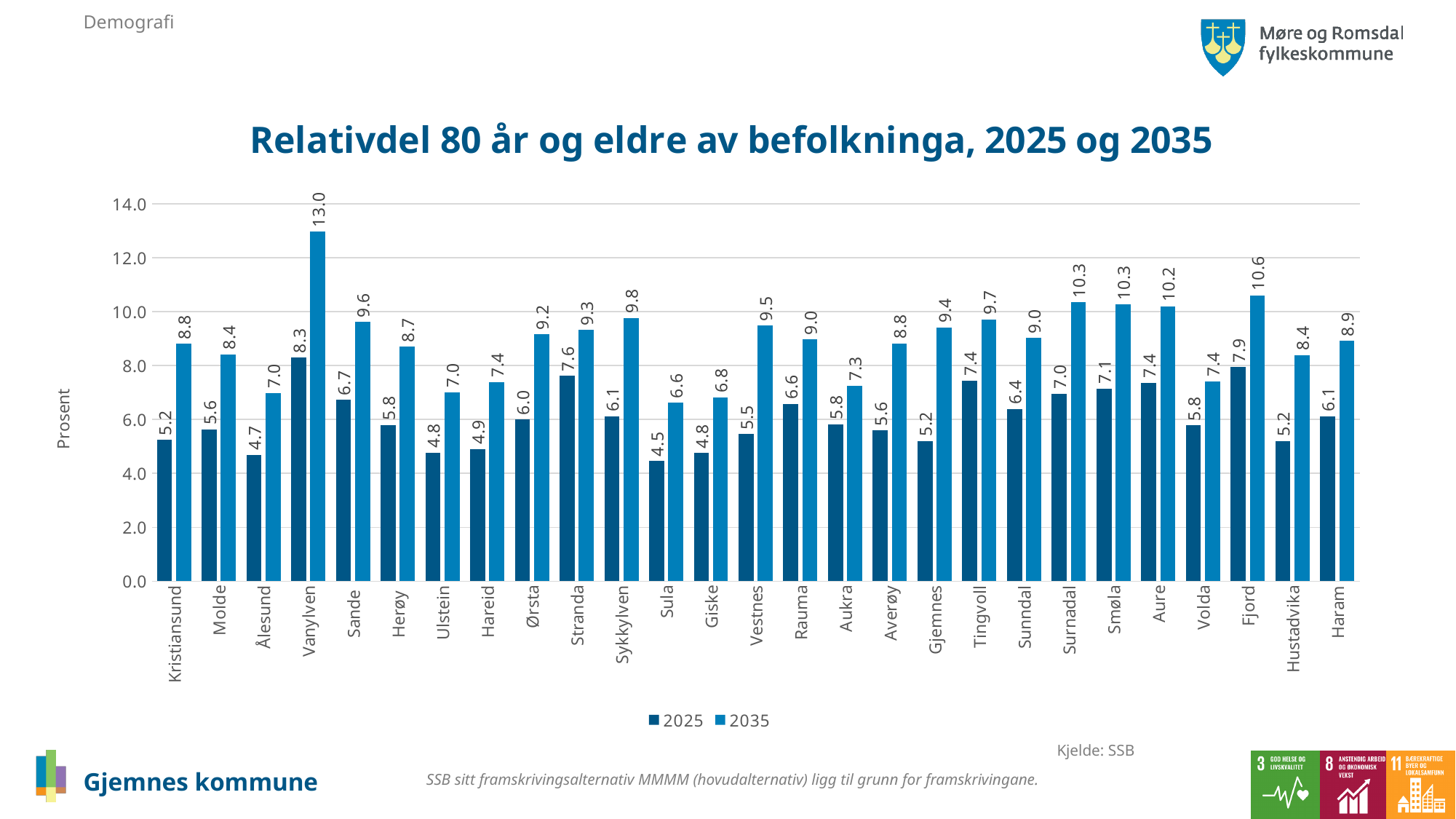
What is the 2035 value for Gjemnes? 9.4 What kind of chart is shown on the slide? Bar chart Which is larger, the 2025 value for Stranda or the 2025 value for Molde? Stranda How many series does the legend list? 2 What is the title of the chart? Relativdel 80 år og eldre av befolkninga, 2025 og 2035 How many municipalities are shown on the x axis? 27 Which municipality has the lowest 2025 value? Sula Which municipality has the highest 2035 value? Vanylven What is the 2035 value for Fjord? 10.6 What is the difference between the 2035 and 2025 values for Gjemnes? 4.2 What is the 2025 value for Vanylven? 8.3 Is the 2035 value for Surnadal greater or less than 10.0? greater